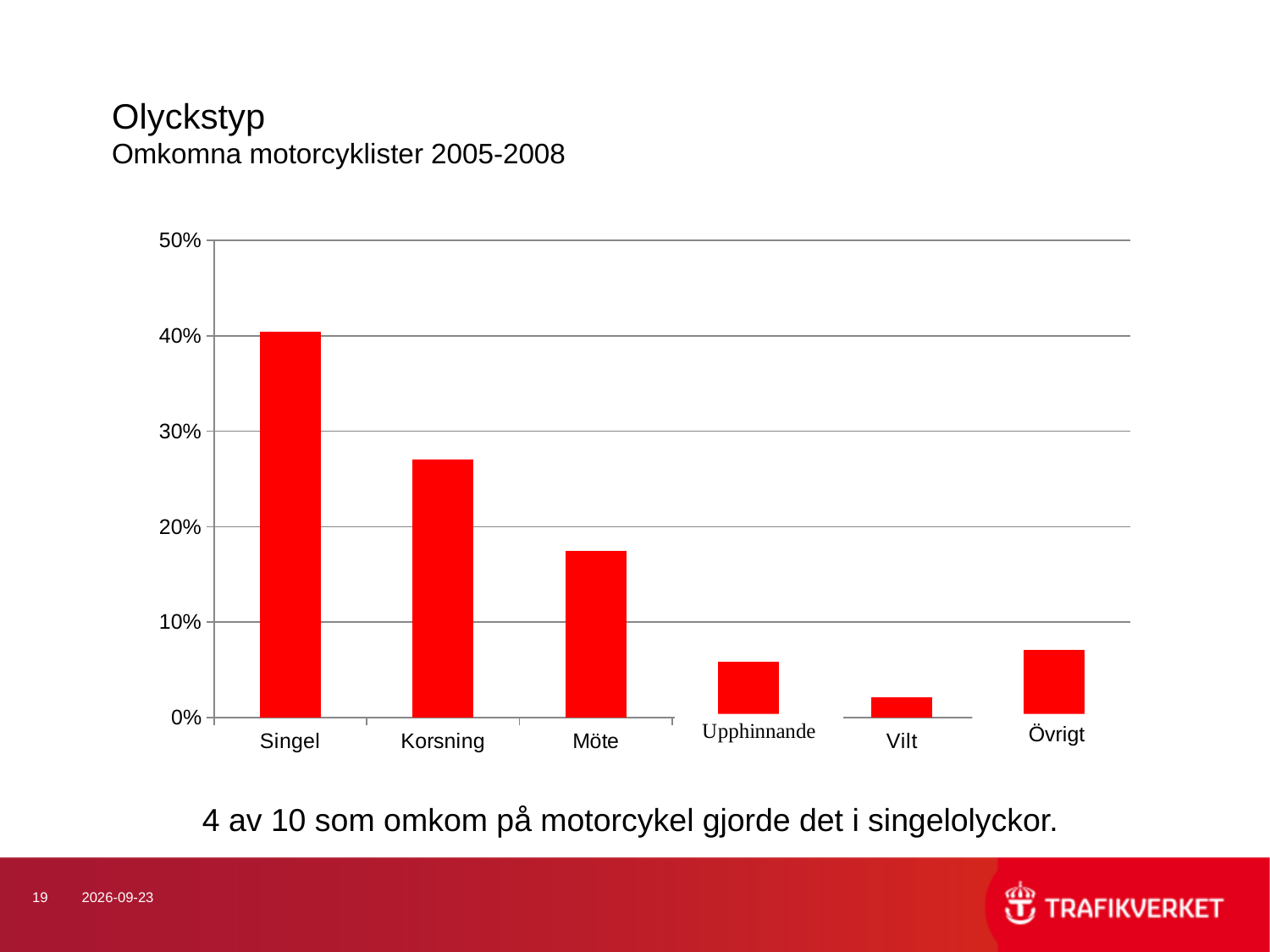
Which category has the lowest value? Vilt What is the title of the chart on the slide? Olyckstyp Which is larger, the value for Vilt or the value for Övrigt? Övrigt Is the value for Singel greater or less than 30%? greater Is the value for Möte greater or less than 20%? less How many accident-type categories are shown on the x axis? 6 Which is larger, the value for Möte or the value for Korsning? Korsning Which category has the highest value? Singel Is the value for Korsning greater or less than 20%? greater What kind of chart is shown on the slide? bar chart